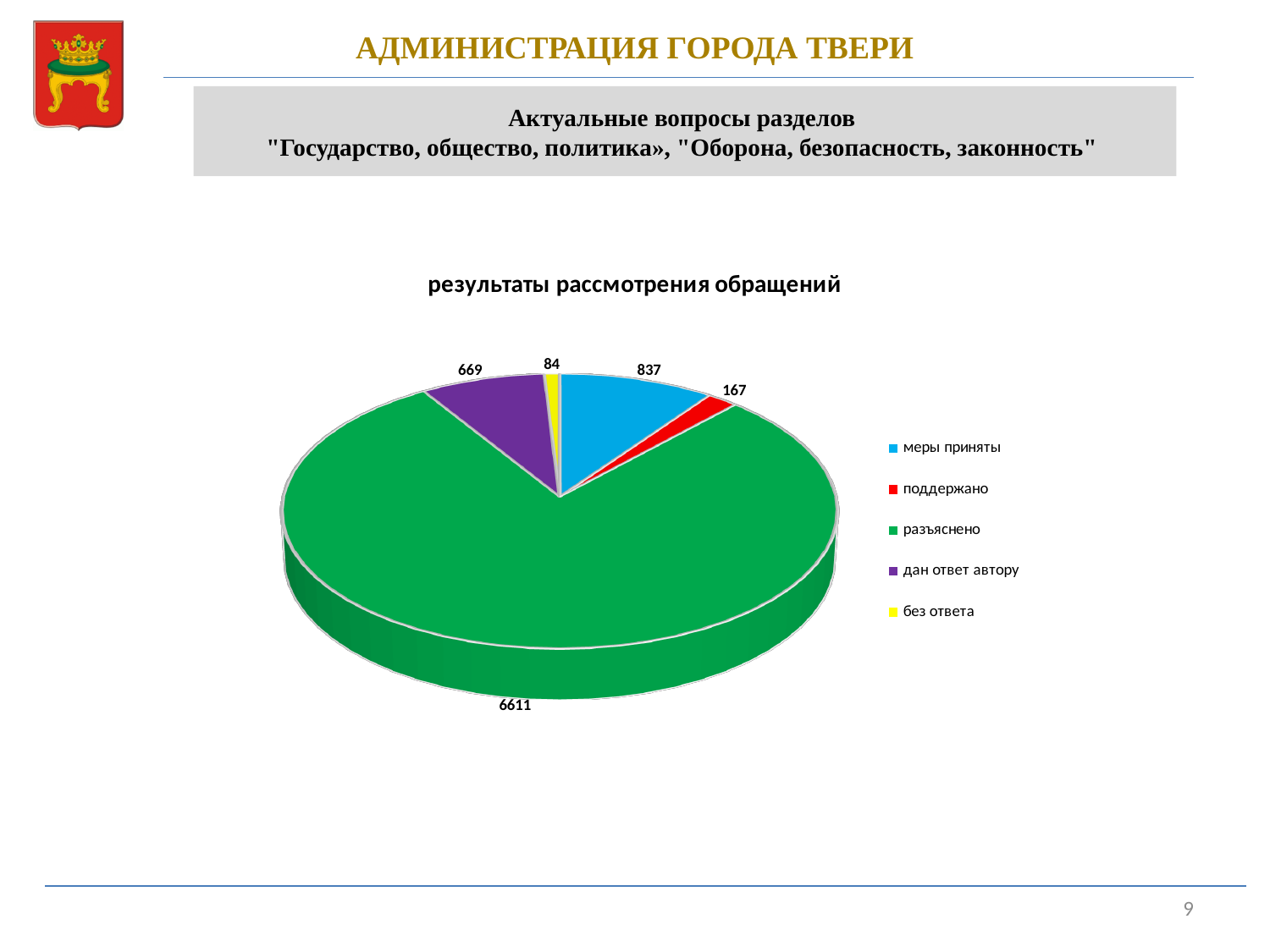
What is the title of the chart? результаты рассмотрения обращений What is the value for "без ответа"? 84 What is the value for "разъяснено"? 6611 What is the value for "поддержано"? 167 What type of chart is shown on the slide? pie chart How many slices does the pie chart have? 5 Which category has the largest slice? разъяснено What is the value for "меры приняты"? 837 Which category has the smallest slice? без ответа What is the value for "дан ответ автору"? 669 Which is larger, the value for "поддержано" or the value for "без ответа"? поддержано What is the difference between the values for "меры приняты" and "дан ответ автору"? 168